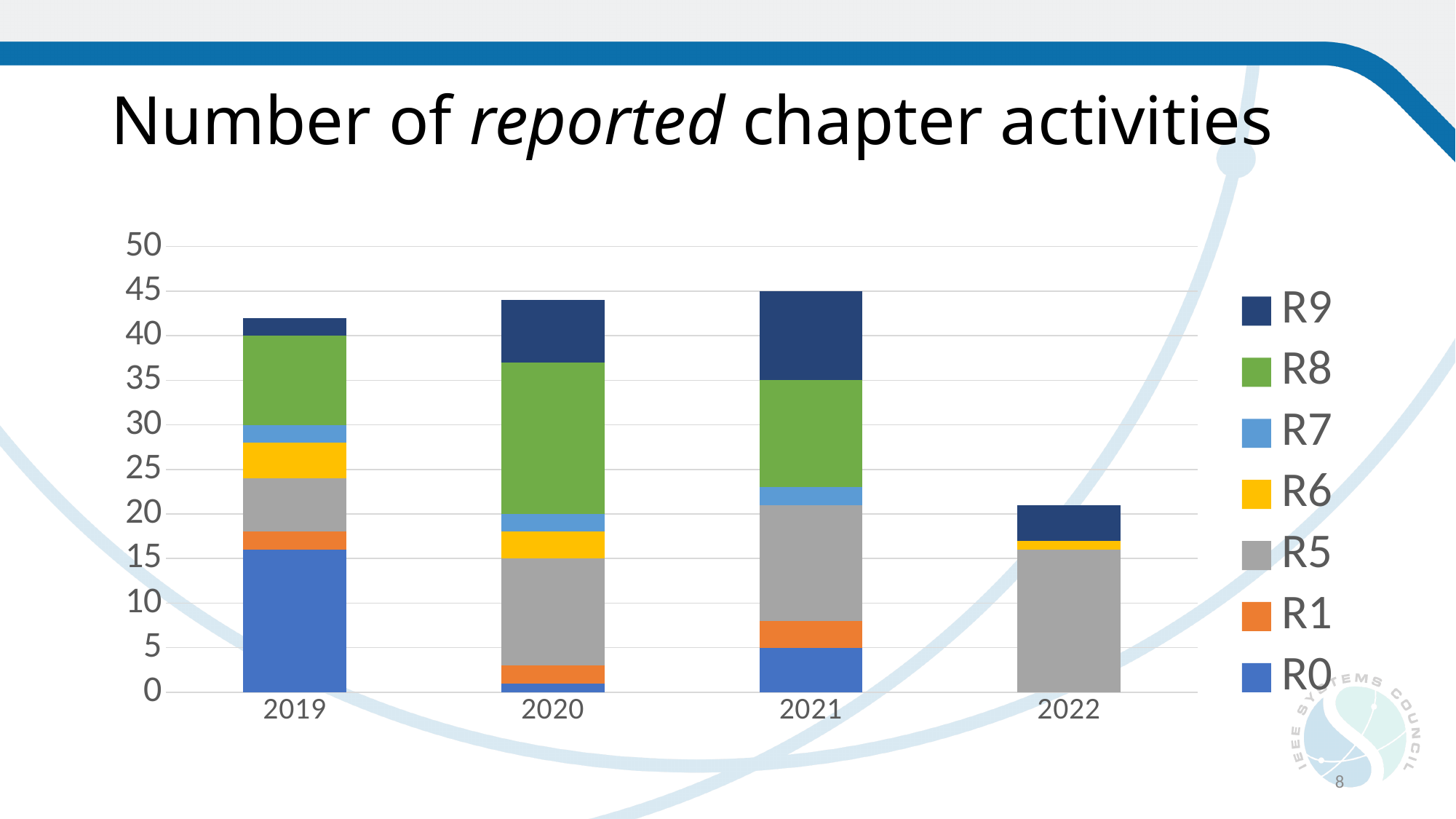
Which year has the lowest total number of reported chapter activities? 2022 How many years are shown on the x axis of the chart? 4 Is the total for 2019 greater or less than 40? greater Is the total for 2022 greater or less than 25? less What is the title of the chart? Number of reported chapter activities Is the R0 segment for 2019 greater or less than 10? greater Which colour represents R5 in the legend? grey What kind of chart is shown on the slide? stacked bar chart How many series does the legend list? 7 Which year has a larger total, 2019 or 2022? 2019